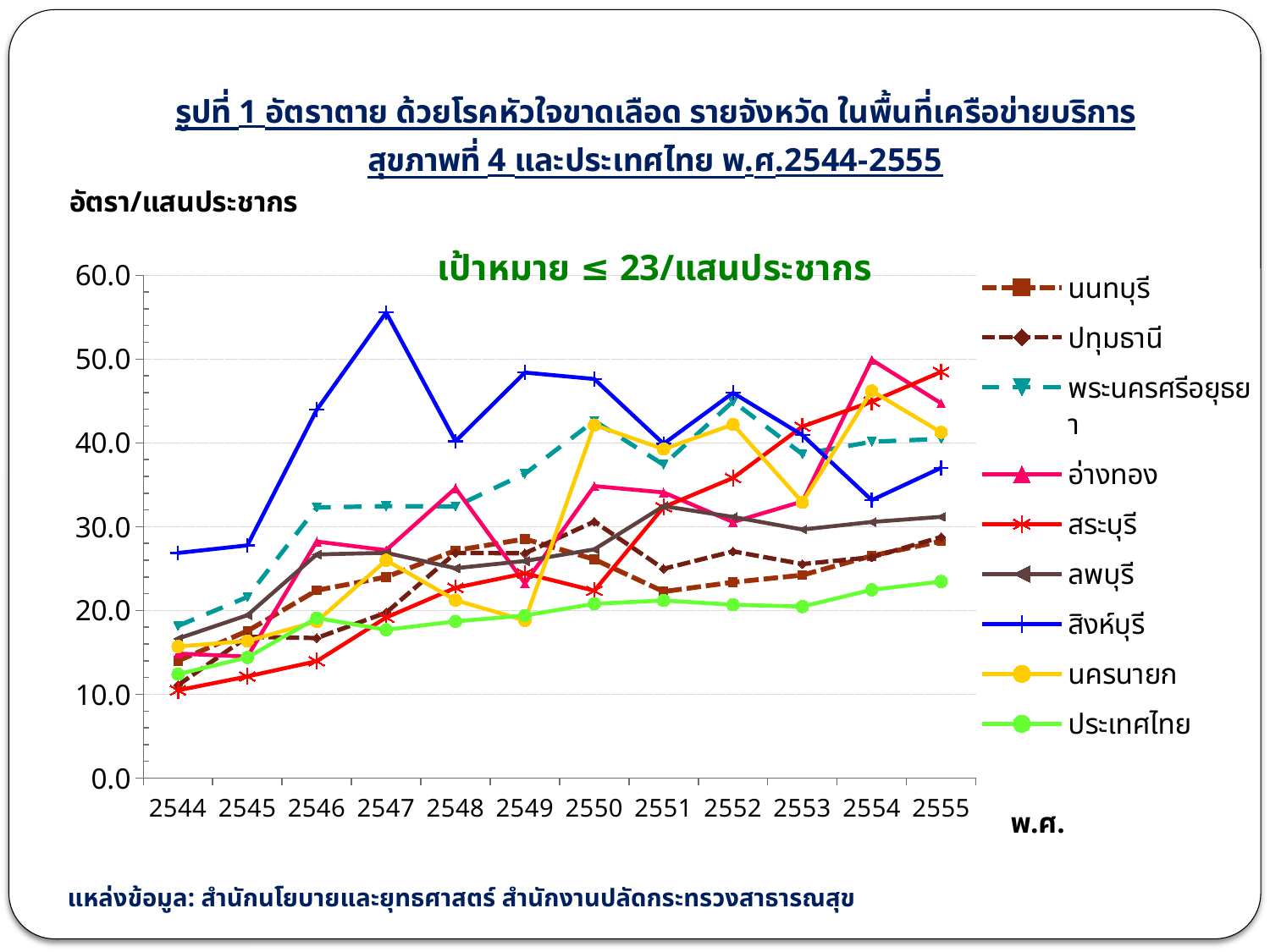
Is the value for สิงห์บุรี in 2547 greater or less than 50.0? greater What is the label of the x axis? พ.ศ. What target is stated in the green text above the chart? เป้าหมาย ≤ 23/แสนประชากร What kind of chart is shown on the slide? line chart How many series does the legend list? 9 How many years are shown along the x axis? 12 Which series has the highest value in 2547? สิงห์บุรี Which series has the lowest value in 2555? ประเทศไทย Does the value for ประเทศไทย rise or fall overall from 2544 to 2555? rise Is the value for สระบุรี in 2555 greater or less than 40.0? greater In 2555, which is larger: the value for สระบุรี or the value for ประเทศไทย? สระบุรี Is the value for ประเทศไทย in 2555 greater or less than 30.0? less